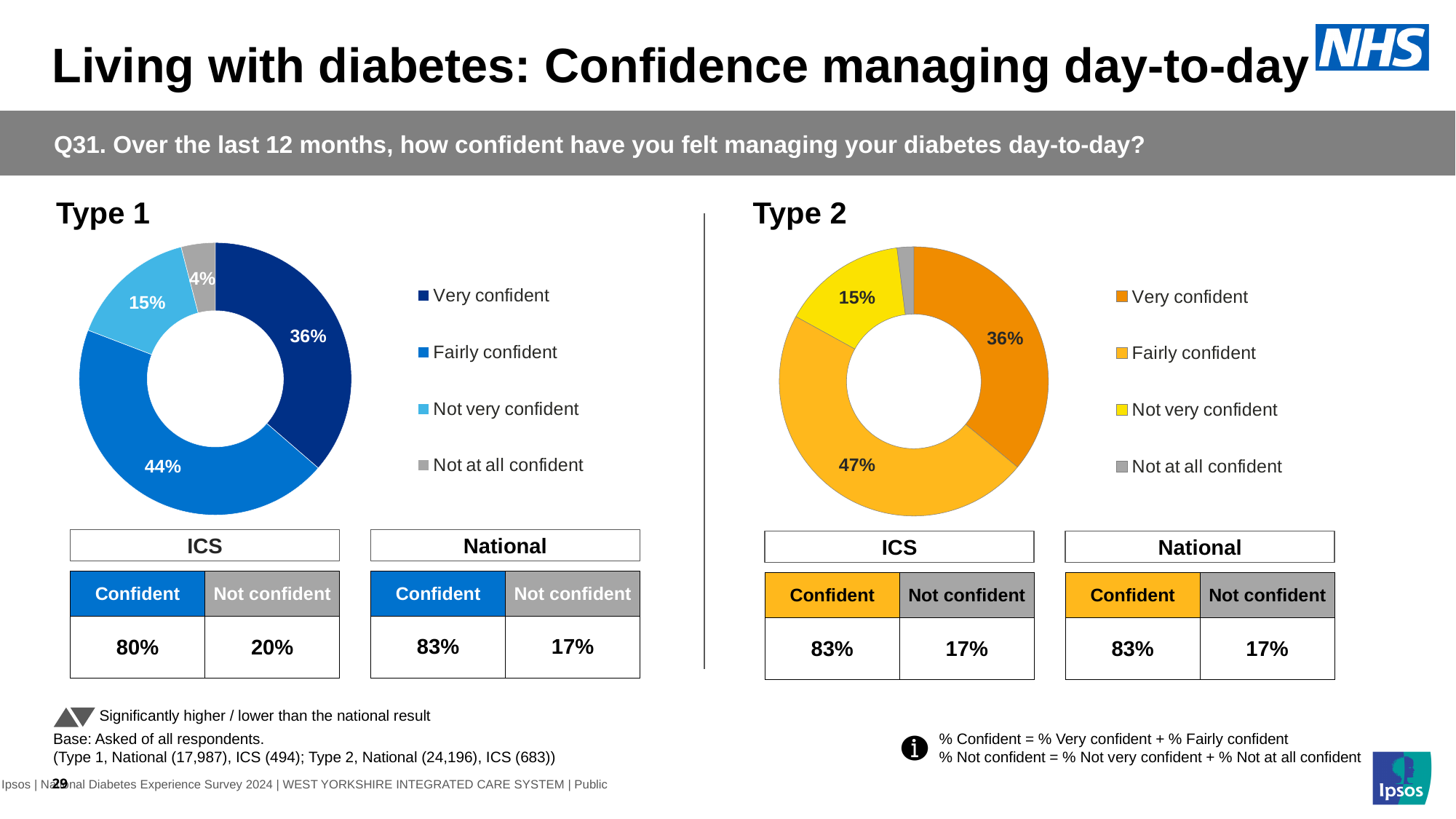
In the Type 2 chart, what percentage of respondents were fairly confident? 47% In the Type 1 chart, what percentage of respondents were not at all confident? 4% In the Type 1 chart, what is the difference between the fairly confident and very confident shares? 8 percentage points How many categories does the legend of the Type 1 chart list? 4 In the Type 1 chart, what percentage of respondents were fairly confident? 44% In the Type 2 chart, which category has the smallest share? Not at all confident In the Type 2 chart, what is the difference between the fairly confident and not very confident shares? 32 percentage points What kind of chart is used for Type 2? Donut (pie) chart In the Type 2 chart, what percentage of respondents were very confident? 36% In the Type 1 chart, what colour represents the not very confident category? Light blue Which is larger: the fairly confident share in the Type 1 chart or in the Type 2 chart? Type 2 In the Type 1 chart, which category has the largest share? Fairly confident